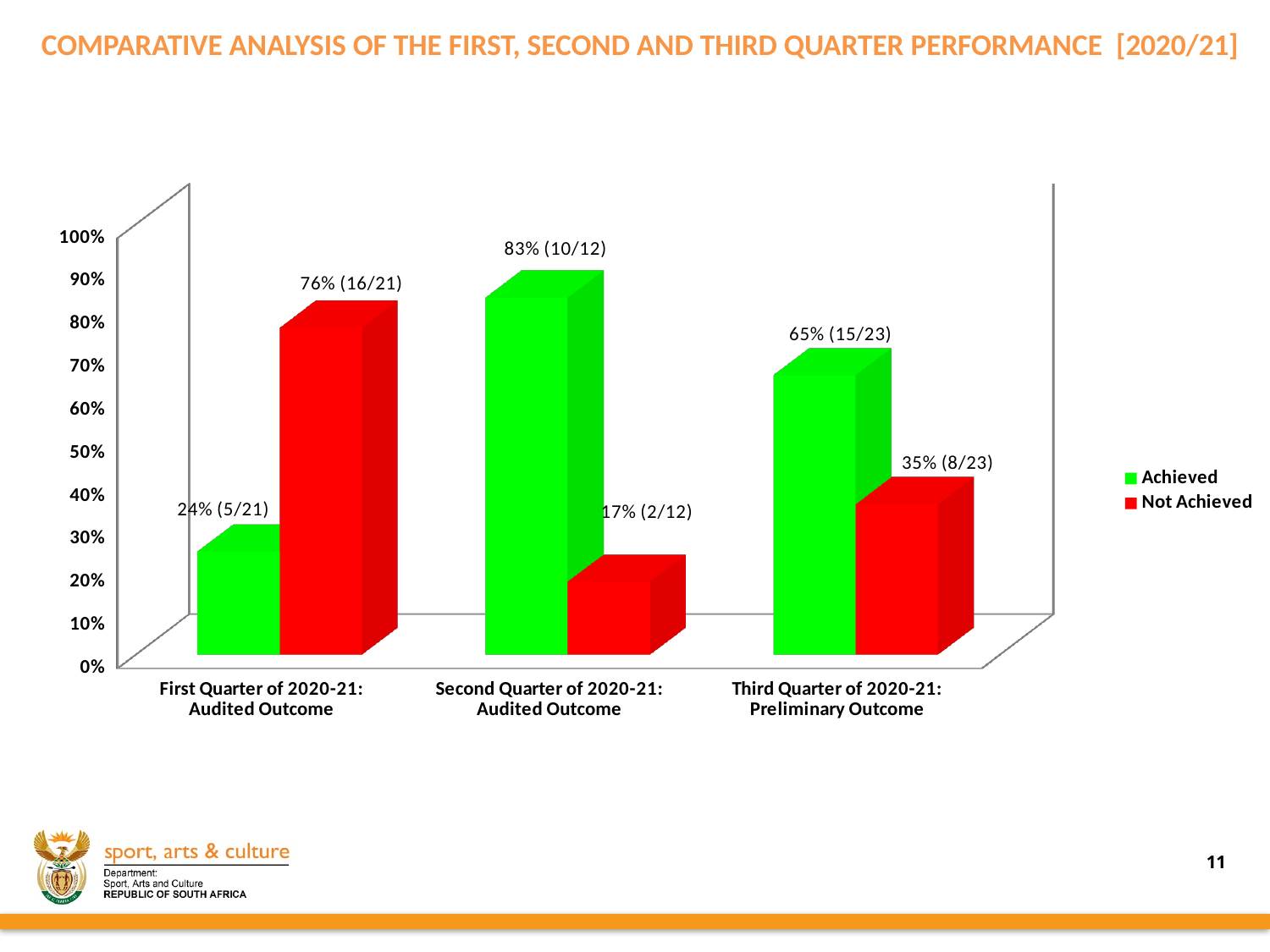
What is the Not Achieved value for the Second Quarter of 2020-21: Audited Outcome? 17% (2/12) How many series does the legend list? 2 Which quarter has the highest Achieved percentage? Second Quarter of 2020-21: Audited Outcome In the First Quarter of 2020-21, which is larger: Achieved or Not Achieved? Not Achieved Which colour represents the Not Achieved series? Red What is the Not Achieved value for the First Quarter of 2020-21: Audited Outcome? 76% (16/21) What is the difference in percentage points between the Achieved values for the Second Quarter and the Third Quarter? 18 Which quarter has the lowest Not Achieved percentage? Second Quarter of 2020-21: Audited Outcome What kind of chart is shown on the slide? Bar chart What is the Achieved value for the Third Quarter of 2020-21: Preliminary Outcome? 65% (15/23) What is the Achieved value for the First Quarter of 2020-21: Audited Outcome? 24% (5/21) How many quarters are shown on the x axis? 3